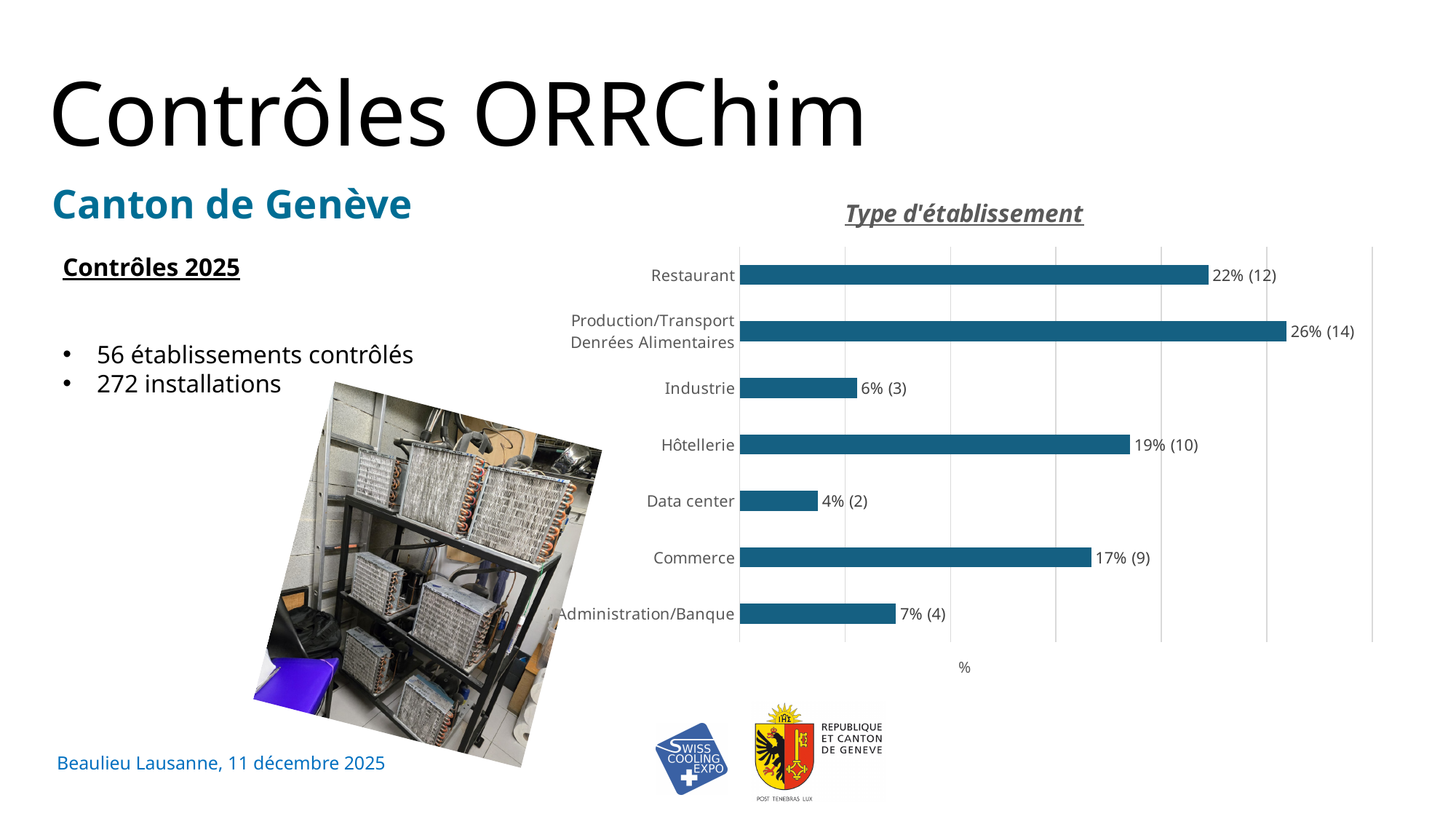
What is the value shown for Data center? 4% (2) What is the value shown for Hôtellerie? 19% (10) Which is larger, the value for Industrie or the value for Administration/Banque? Administration/Banque What is the value shown for Restaurant in the 'Type d'établissement' chart? 22% (12) What is the difference in percentage points between Restaurant and Commerce? 5 Which category has the highest value in the chart? Production/Transport Denrées Alimentaires What label is shown on the horizontal axis of the chart? % What kind of chart is shown on the slide? Bar chart How many categories are shown in the chart? 7 Which category has the lowest value in the chart? Data center How many more establishments are counted for Hôtellerie than for Industrie? 7 What is the title of the chart? Type d'établissement